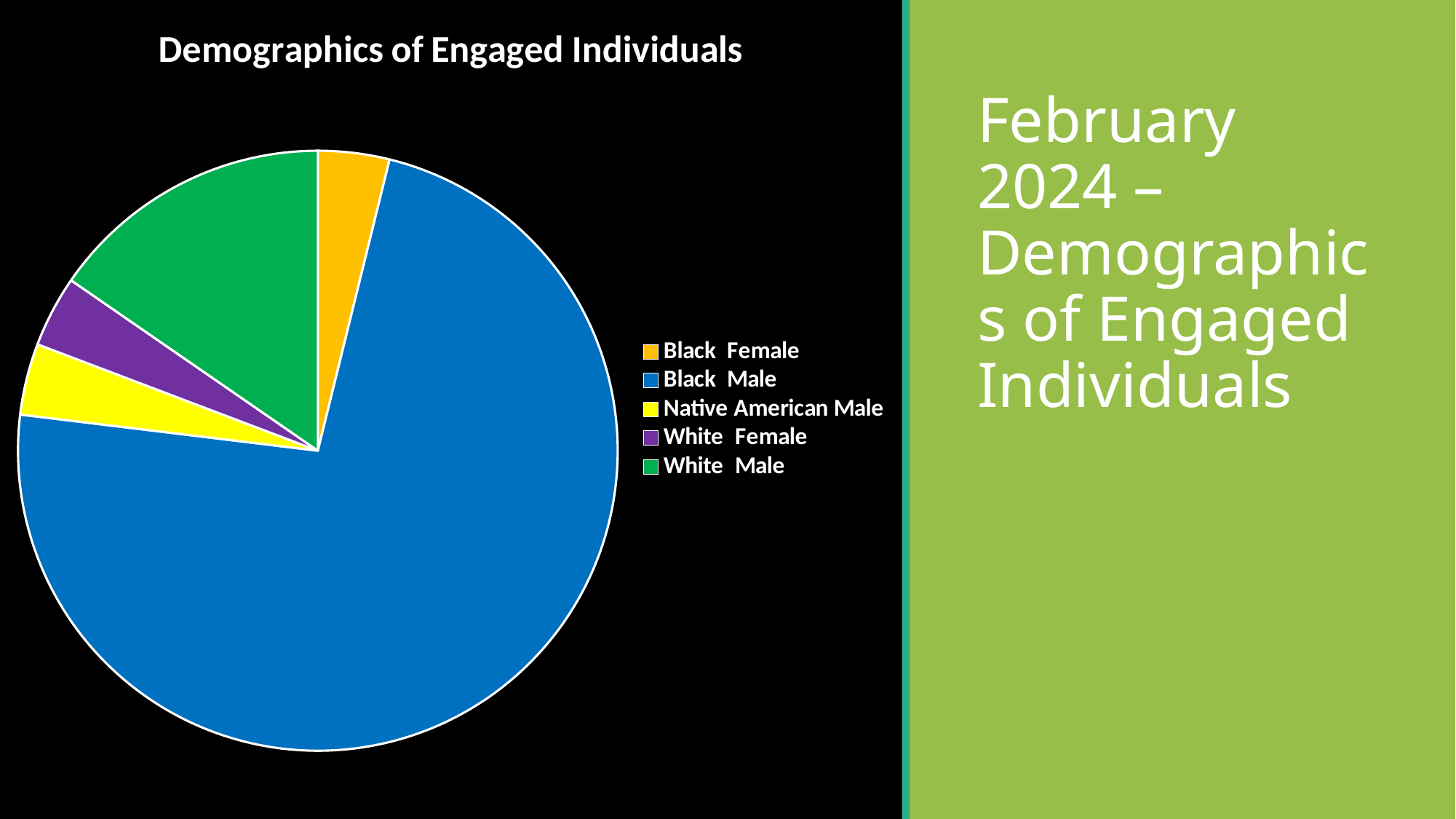
What colour represents Black Male in the pie chart? Blue Which slice is larger, White Male or White Female? White Male Which category is the second-largest slice of the pie? White Male What kind of chart is shown on the slide? Pie chart Which slice is larger, Black Male or White Male? Black Male Which category has the largest slice of the pie? Black Male Which slice is larger, White Male or Black Female? White Male How many categories does the pie chart have? 5 What is the title of the chart? Demographics of Engaged Individuals Does the Black Male slice account for more or less than half of the pie? More